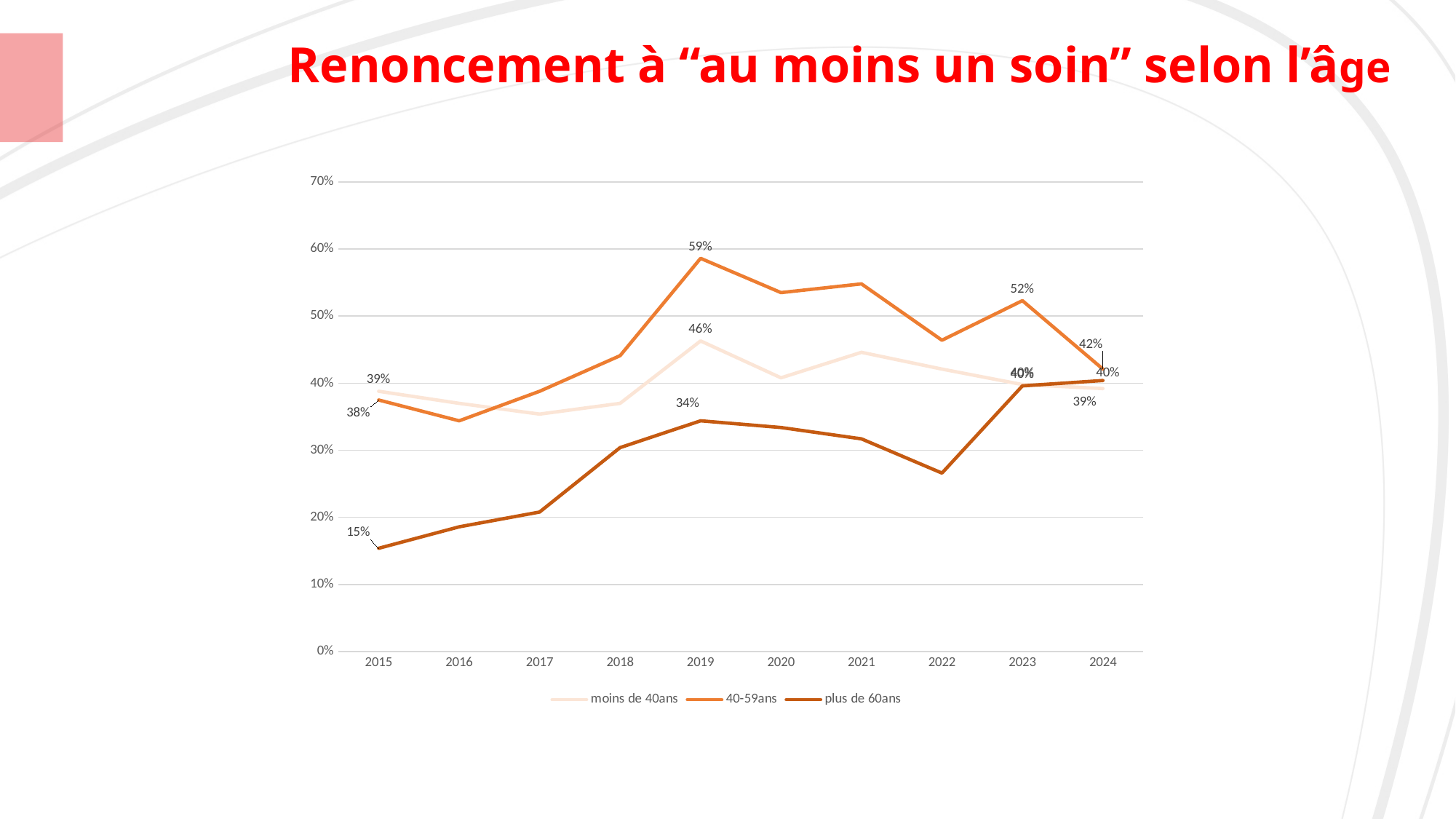
Which series has the highest value in 2019? 40-59ans What is the value for the plus de 60ans series in 2015? 15% How many series does the legend list? 3 What is the difference between the 40-59ans value and the plus de 60ans value in 2019? 25 percentage points In 2015, which is larger: the moins de 40ans value or the plus de 60ans value? moins de 40ans How many years are plotted along the x axis? 10 What is the value for the 40-59ans series in 2019? 59% Is the value for plus de 60ans in 2022 greater or less than 30%? less What kind of chart is shown on the slide? line chart What is the value for the moins de 40ans series in 2019? 46% What is the value for the 40-59ans series in 2024? 42% Does the plus de 60ans series rise or fall from 2015 to 2019? rise